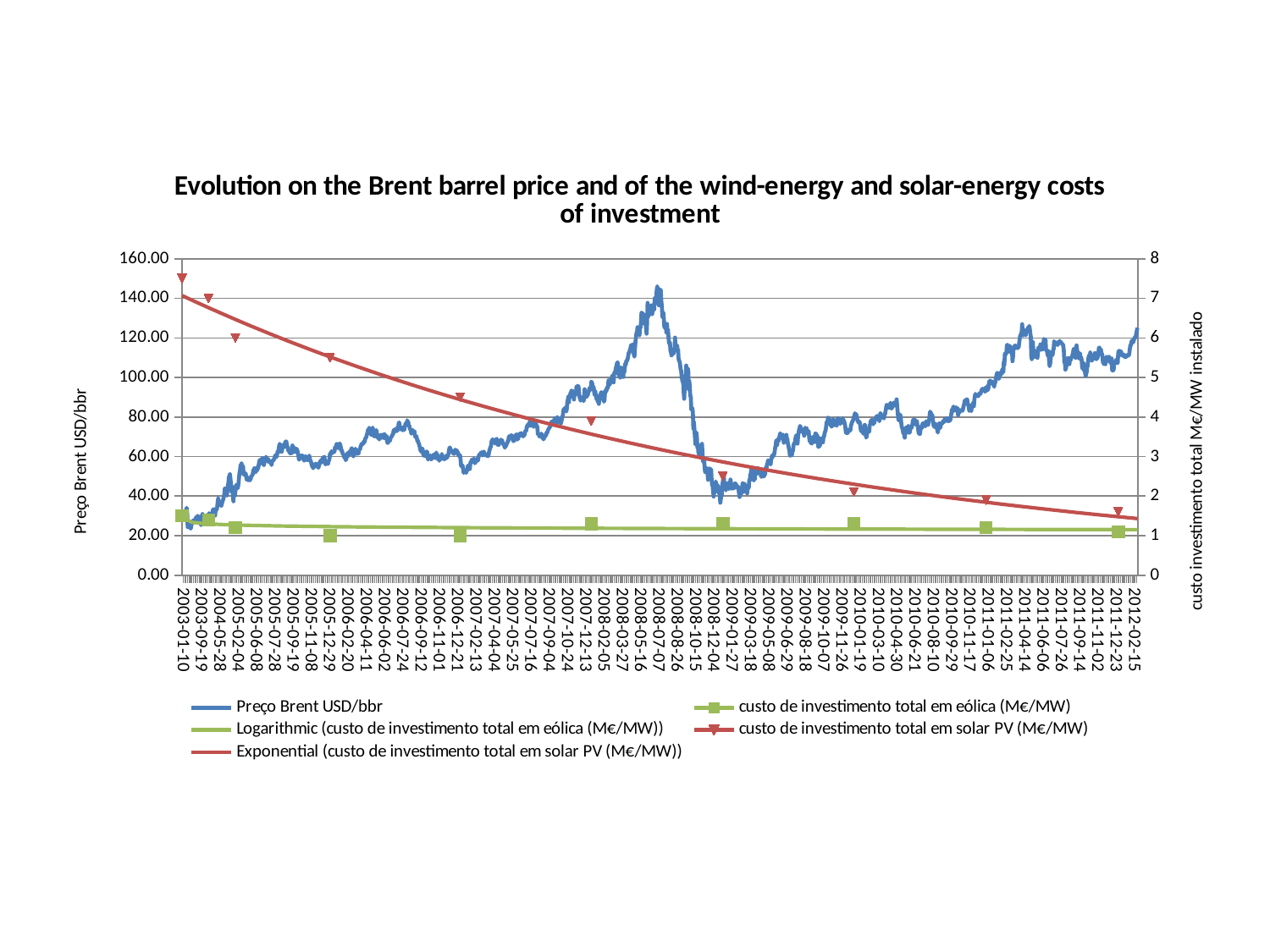
What is the title of the chart? Evolution on the Brent barrel price and of the wind-energy and solar-energy costs of investment What kind of chart is shown on the slide? line chart Is the solar PV investment cost higher at 2003-01-10 or at 2012-02-15? 2003-01-10 Is the Brent price (USD/bbr) around 2008-07-07 greater or less than 120.00? greater Is the Brent price (USD/bbr) around 2009-01-27 greater or less than 60.00? less Is the solar PV investment cost marker at 2012-02-15 greater or less than 2 on the right axis? less Does the Exponential trend line for the solar PV investment cost rise or fall from left to right? fall Does the Brent price generally rise or fall between 2003-01-10 and 2008-07-07? rise What is the label of the left vertical axis? Preço Brent USD/bbr How many series does the legend list? 5 Which is higher at 2003-01-10: the solar PV investment cost or the wind investment cost? solar PV investment cost